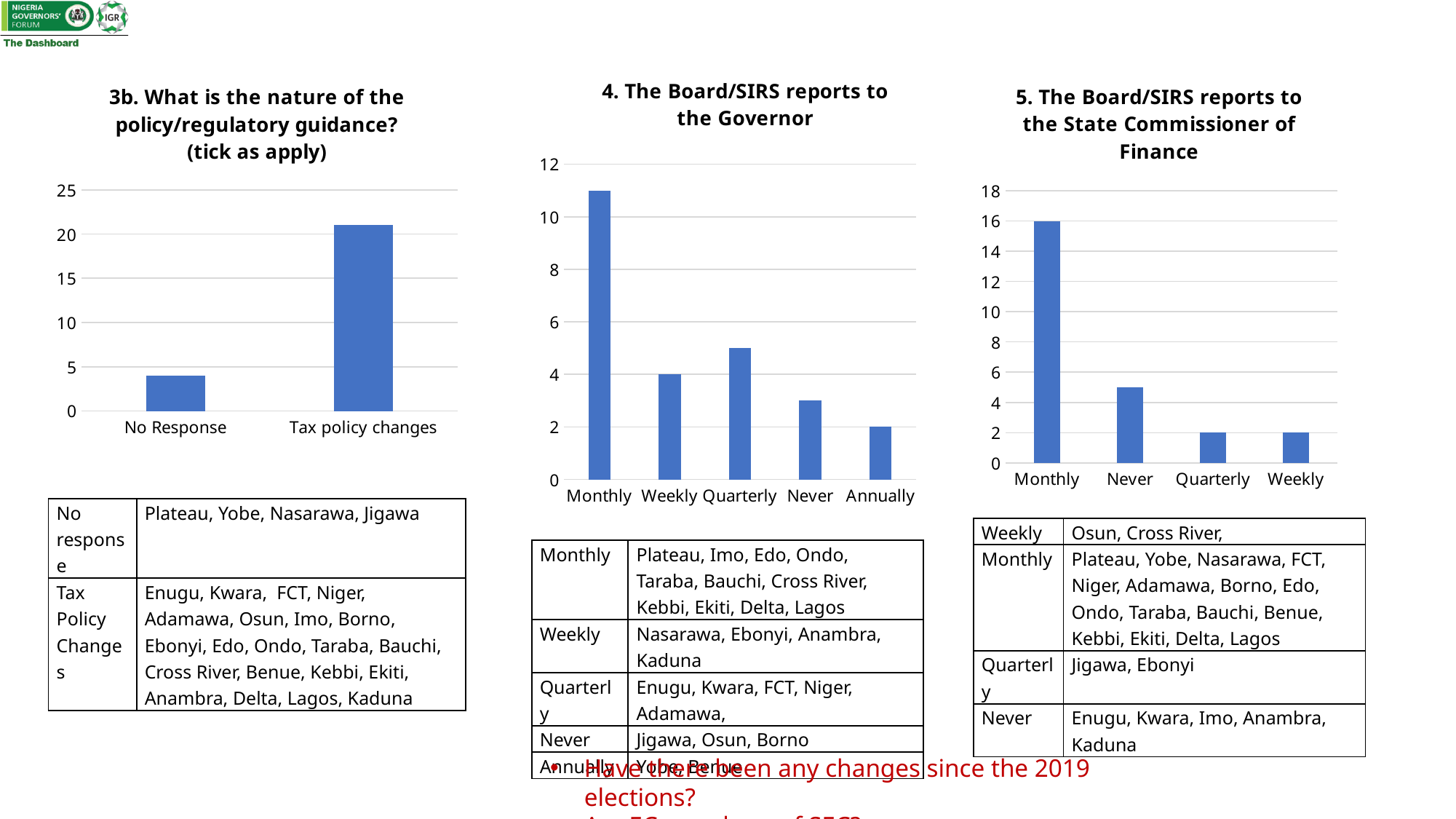
In the chart titled '4. The Board/SIRS reports to the Governor', which category has the lowest value? Annually In the chart titled '4. The Board/SIRS reports to the Governor', what is the value for Weekly? 4 How many categories are shown in the chart titled '3b. What is the nature of the policy/regulatory guidance?'? 2 In the chart titled '4. The Board/SIRS reports to the Governor', is the value for Monthly greater or less than 10? greater In the chart titled '5. The Board/SIRS reports to the State Commissioner of Finance', what is the value for Monthly? 16 In the chart titled '3b. What is the nature of the policy/regulatory guidance?', is the value for No Response greater or less than 5? less In the chart titled '5. The Board/SIRS reports to the State Commissioner of Finance', which is larger, Never or Quarterly? Never What type of chart is the chart titled '5. The Board/SIRS reports to the State Commissioner of Finance'? bar chart In the chart titled '4. The Board/SIRS reports to the Governor', which category has the highest value? Monthly How many categories are shown in the chart titled '4. The Board/SIRS reports to the Governor'? 5 In the chart titled '3b. What is the nature of the policy/regulatory guidance?', which category has the higher value? Tax policy changes In the chart titled '3b. What is the nature of the policy/regulatory guidance?', is the value for Tax policy changes greater or less than 20? greater